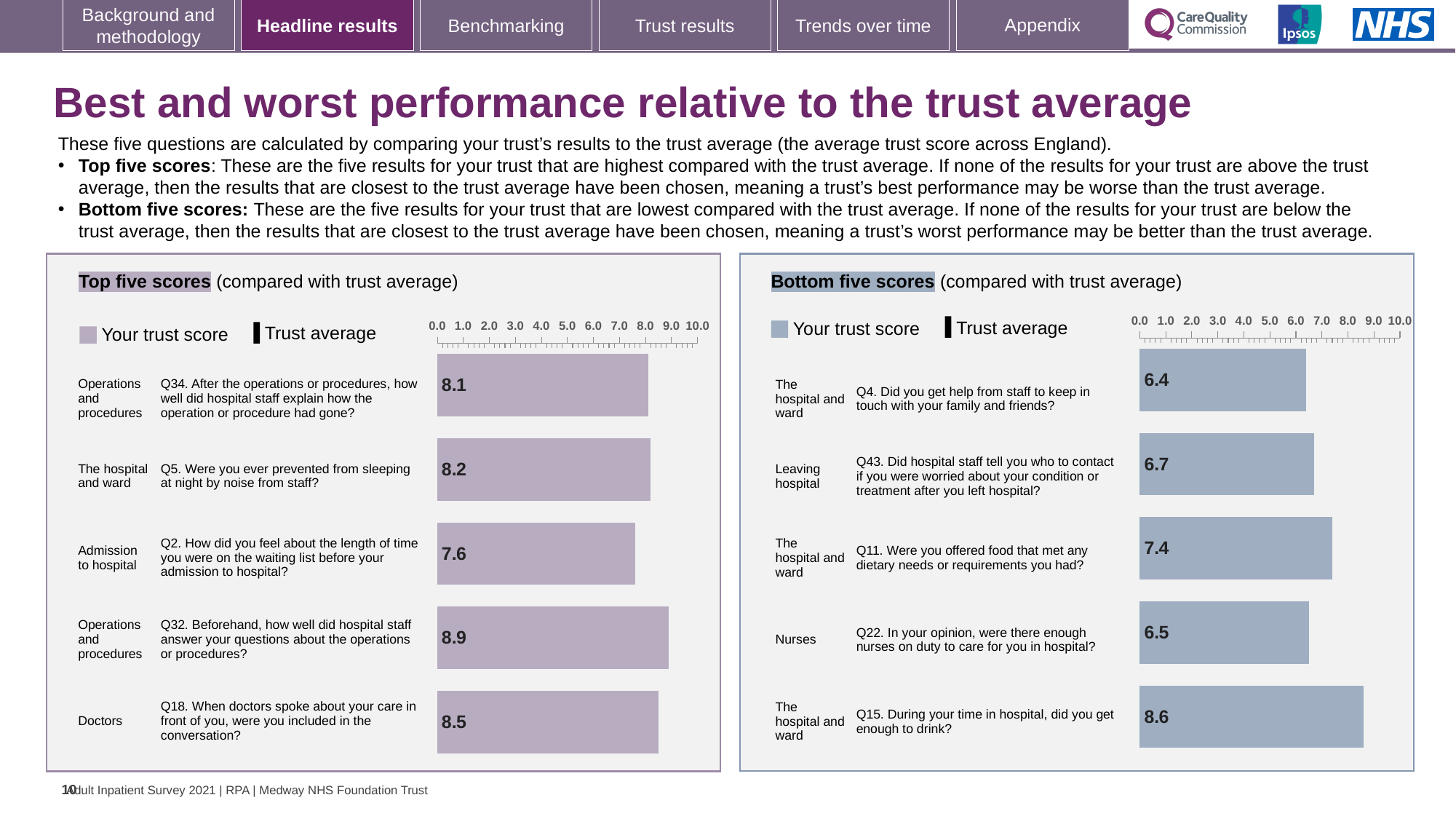
In the Top five scores chart, what is the difference between the scores for Q32 and Q2? 1.3 In the Top five scores chart, which question has the lowest trust score? Q2 In the Top five scores chart, which question has the highest trust score? Q32 What two entries does the legend of the Bottom five scores chart list? Your trust score and Trust average In the Top five scores chart, which has the larger trust score, Q5 or Q18? Q18 What type of chart is the Top five scores chart? Bar chart In the Bottom five scores chart, which question has the lowest trust score? Q4 How many questions are plotted in the Bottom five scores chart? 5 In the Bottom five scores chart, what is the difference between the scores for Q11 and Q4? 1.0 In the Bottom five scores chart, what is the trust score for Q15 (did you get enough to drink)? 8.6 In the Bottom five scores chart, which question has the highest trust score? Q15 In the Top five scores chart, what is the trust score for Q34 (how well hospital staff explained how the operation or procedure had gone)? 8.1